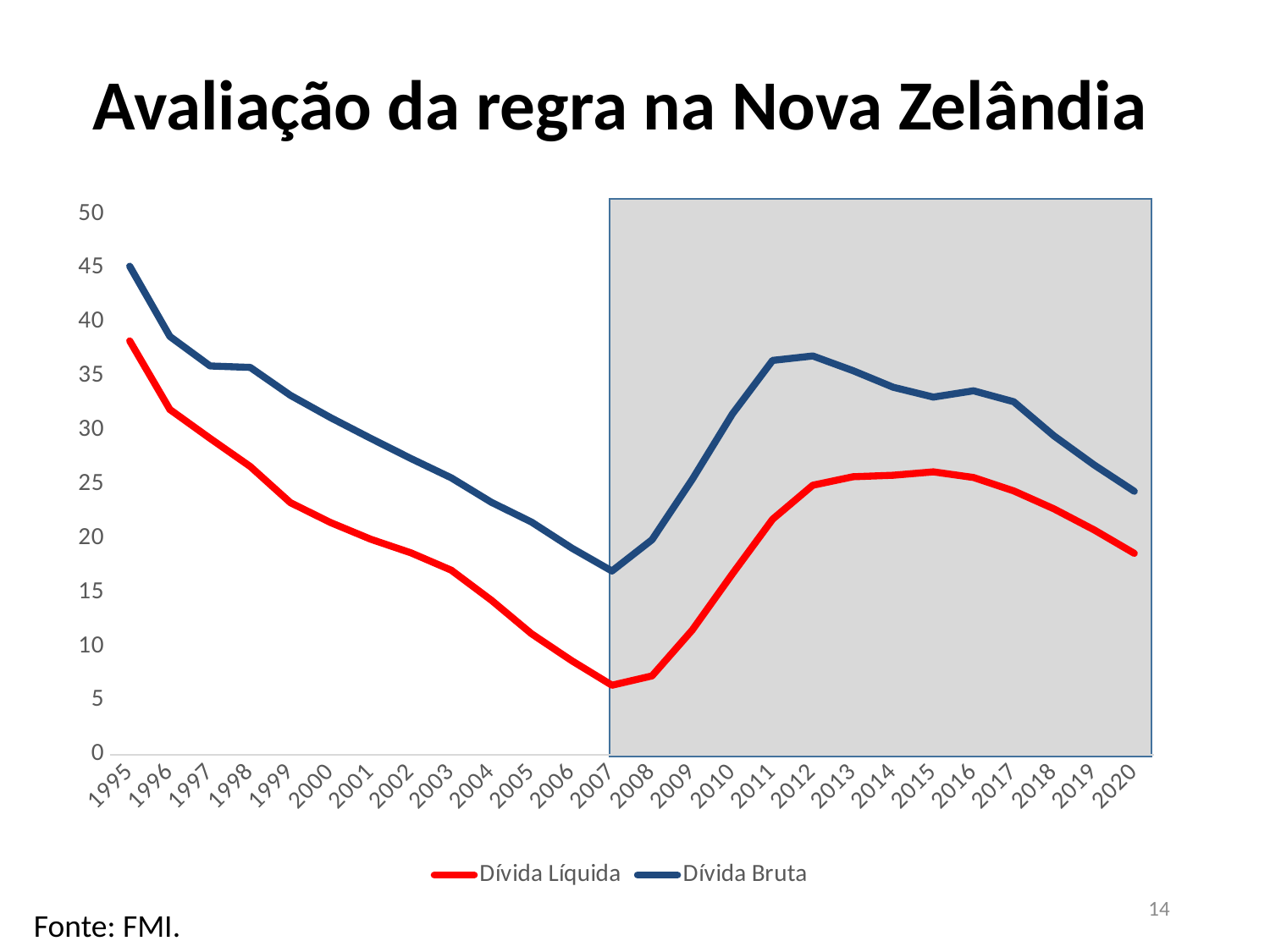
Is the value for Dívida Líquida in 2007 greater or less than 10? less In which year is Dívida Líquida at its lowest? 2007 In which year is Dívida Bruta at its highest? 1995 Which two series are listed in the legend? Dívida Líquida and Dívida Bruta What is the title of the chart? Avaliação da regra na Nova Zelândia What kind of chart is shown on the slide? line chart Is the value for Dívida Bruta in 1995 greater or less than 40? greater Is the value for Dívida Bruta in 2020 greater or less than 20? greater How many series does the legend list? 2 How many years are plotted along the x axis? 26 Does Dívida Líquida rise or fall from 1995 to 2007? fall